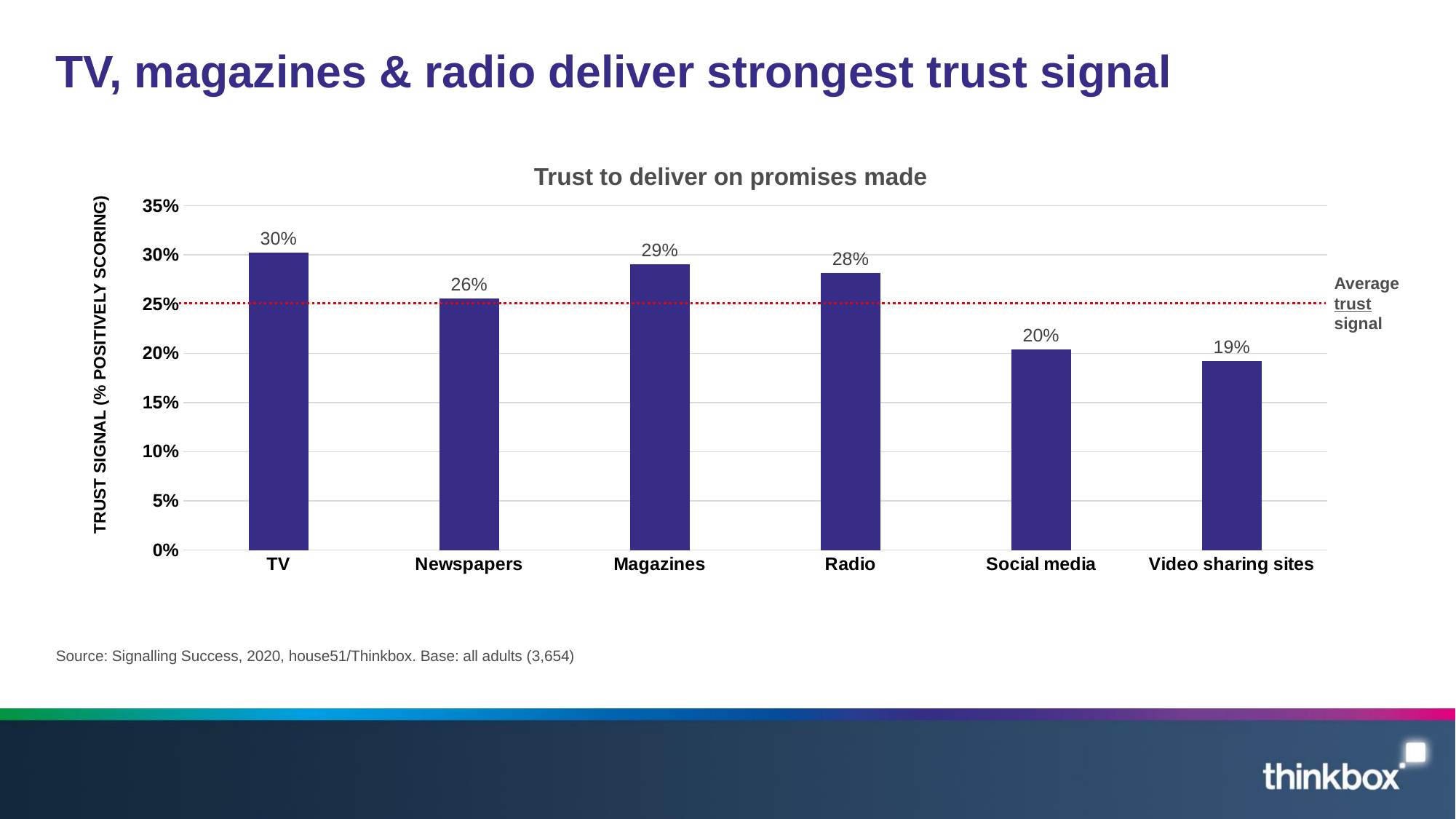
What kind of chart is shown on the slide? Bar chart Which category has the highest trust signal? TV What is the trust signal value for Social media? 20% Is the value for Social media greater or less than 25%? less What is the title of the chart? Trust to deliver on promises made What is the trust signal value for Newspapers? 26% What is the difference between the trust signal for TV and for Video sharing sites? 11% What is the trust signal value for TV? 30% Which has a higher trust signal, Radio or Newspapers? Radio What is the difference between the trust signal for Magazines and for Social media? 9% How many categories are shown on the x axis? 6 Which category has the lowest trust signal? Video sharing sites